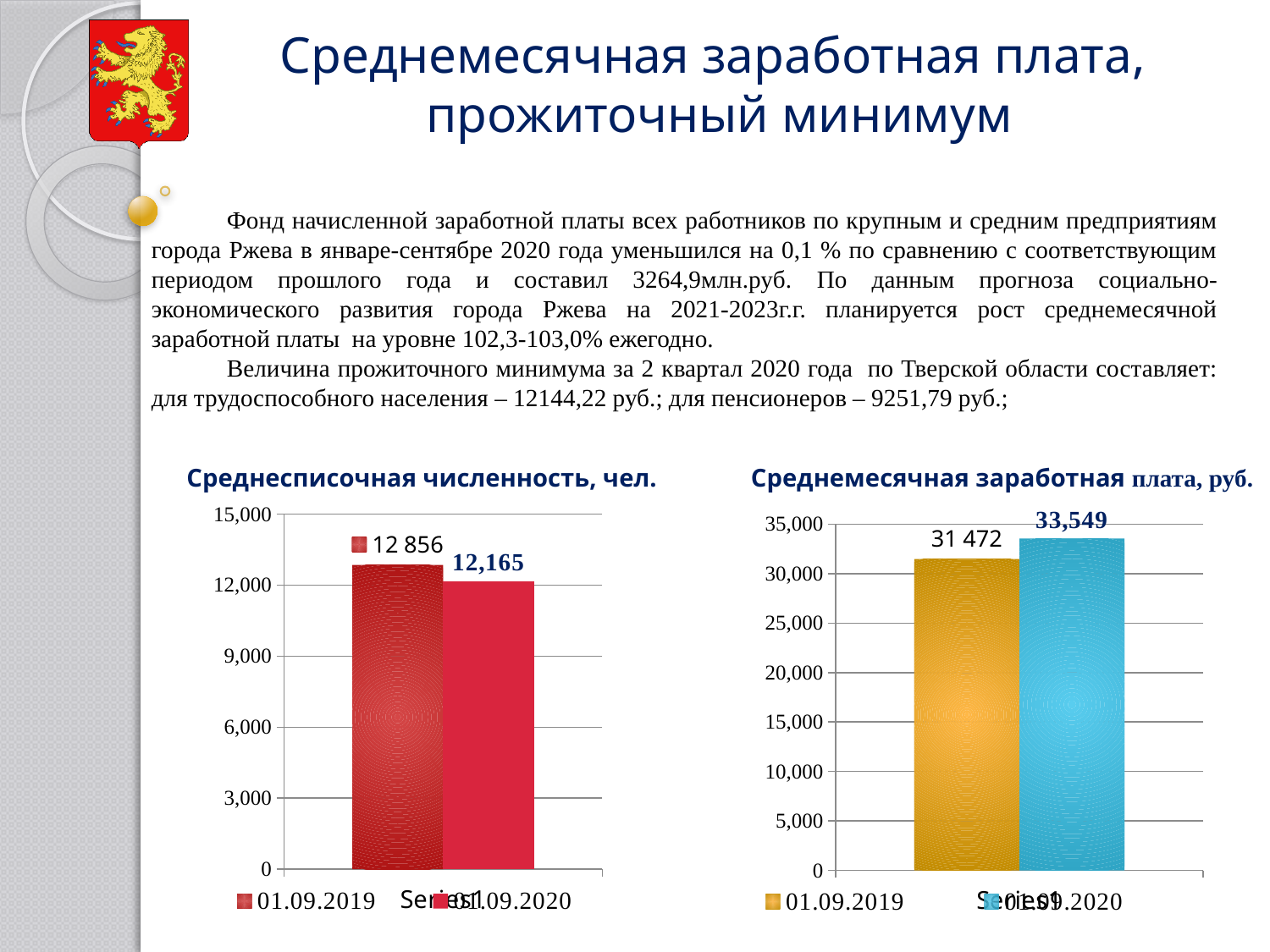
In the chart titled "Среднемесячная заработная плата, руб.", is the value for 01.09.2019 greater or less than 30,000? greater In the chart titled "Среднемесячная заработная плата, руб.", by how much does the 01.09.2020 value exceed the 01.09.2019 value? 2,077 In the chart titled "Среднесписочная численность, чел.", what is the value for 01.09.2019? 12 856 In the chart titled "Среднесписочная численность, чел.", what is the value for 01.09.2020? 12,165 In the chart titled "Среднемесячная заработная плата, руб.", what is the value for 01.09.2019? 31 472 In the chart titled "Среднесписочная численность, чел.", what is the difference between the 01.09.2019 and 01.09.2020 values? 691 How many series does the legend of the chart titled "Среднемесячная заработная плата, руб." list? 2 In the chart titled "Среднемесячная заработная плата, руб.", what is the value for 01.09.2020? 33,549 In the chart titled "Среднесписочная численность, чел.", which date has the higher value? 01.09.2019 In the chart titled "Среднемесячная заработная плата, руб.", which date has the lower value? 01.09.2019 What kind of chart is the chart titled "Среднесписочная численность, чел."? bar chart In the chart titled "Среднемесячная заработная плата, руб.", what colour is the bar for 01.09.2020? blue